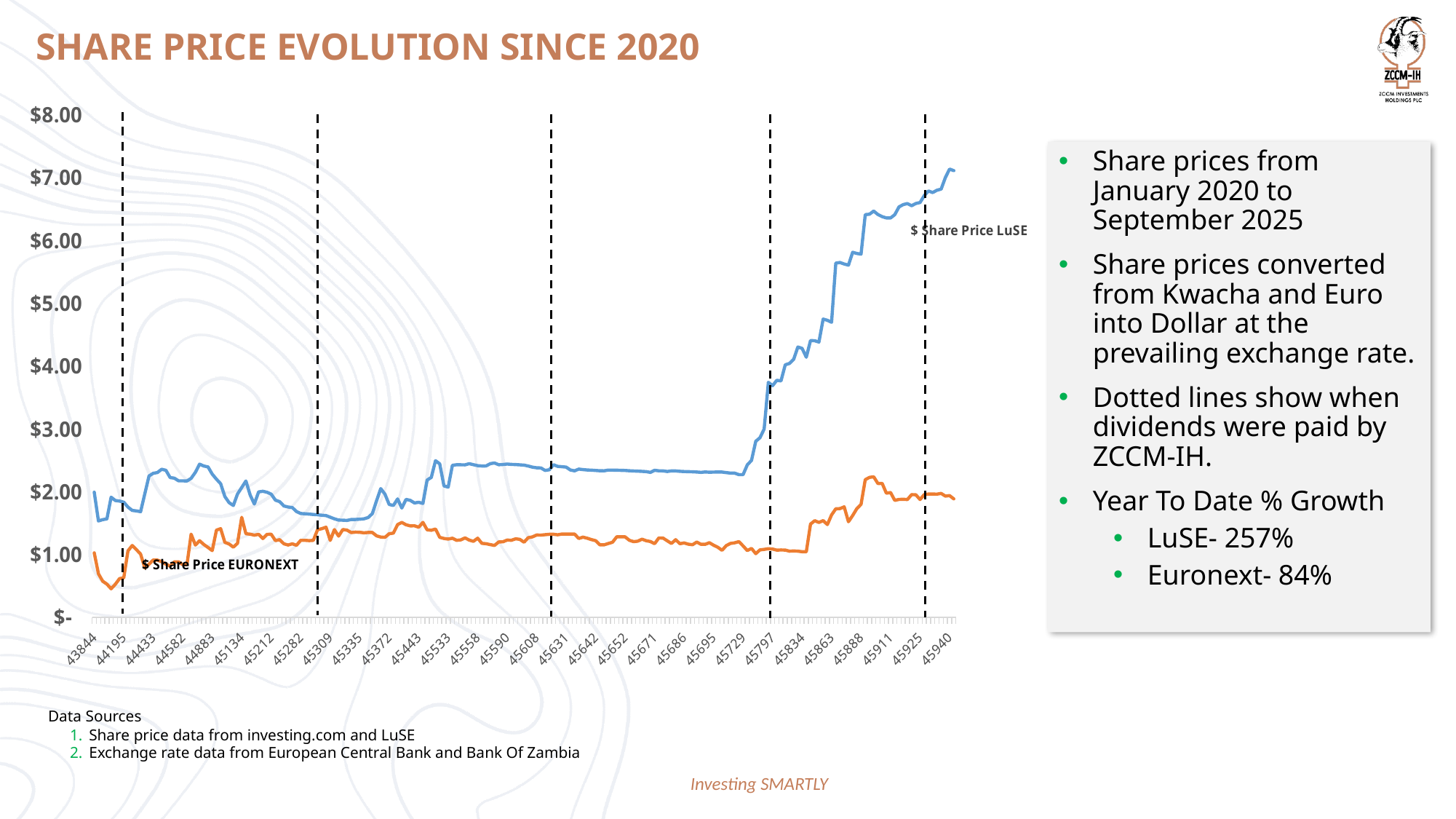
What is the title of the chart on the slide? SHARE PRICE EVOLUTION SINCE 2020 Is the highest value reached by $ Share Price EURONEXT greater or less than $3.00? less At the last point (45940), which series has the higher value, $ Share Price LuSE or $ Share Price EURONEXT? $ Share Price LuSE Is the value for $ Share Price LuSE at 45652 greater or less than $3.00? less Which series is plotted in blue? $ Share Price LuSE Does the $ Share Price LuSE series rise or fall between 45729 and 45940? rise Is the value for $ Share Price EURONEXT at the last point (45940) greater or less than $3.00? less What is the highest value shown on the y axis? $8.00 What kind of chart is shown on the slide? line chart How many series are plotted on the chart? 2